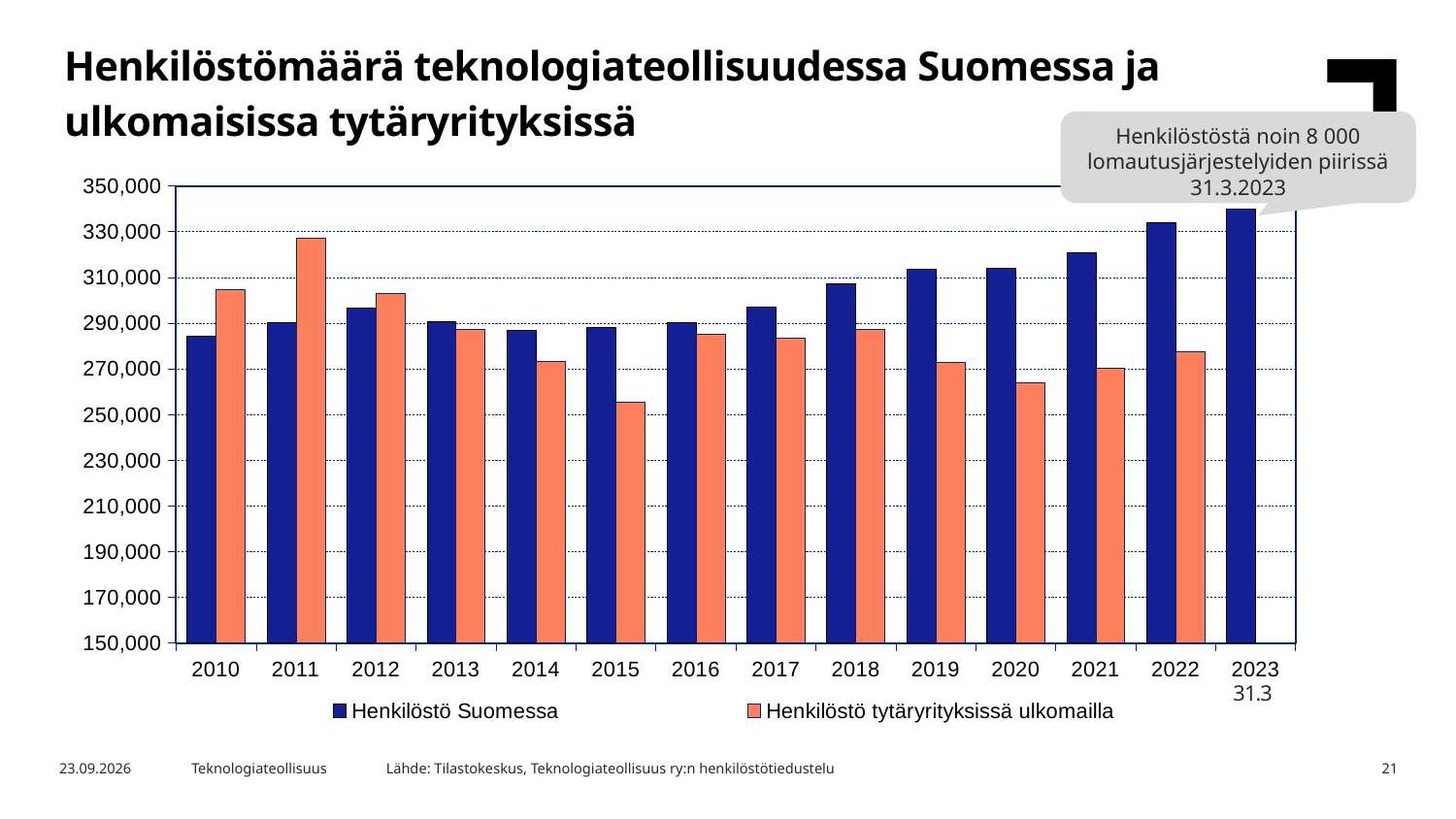
Does the value for Henkilöstö Suomessa rise or fall from 2015 to 2023? rise Is the value for Henkilöstö Suomessa in 2023 greater or less than 330,000? greater In which year is the value for Henkilöstö tytäryrityksissä ulkomailla lowest? 2015 Is the value for Henkilöstö tytäryrityksissä ulkomailla in 2015 greater or less than 270,000? less Is the value for Henkilöstö Suomessa in 2021 greater or less than 310,000? greater In which year is the value for Henkilöstö Suomessa highest? 2023 In 2019, which series has the larger value: Henkilöstö Suomessa or Henkilöstö tytäryrityksissä ulkomailla? Henkilöstö Suomessa In 2011, which series has the larger value: Henkilöstö Suomessa or Henkilöstö tytäryrityksissä ulkomailla? Henkilöstö tytäryrityksissä ulkomailla In which year is the value for Henkilöstö tytäryrityksissä ulkomailla highest? 2011 How many years are shown on the x axis? 14 What kind of chart is shown on the slide? bar chart How many series does the legend list? 2